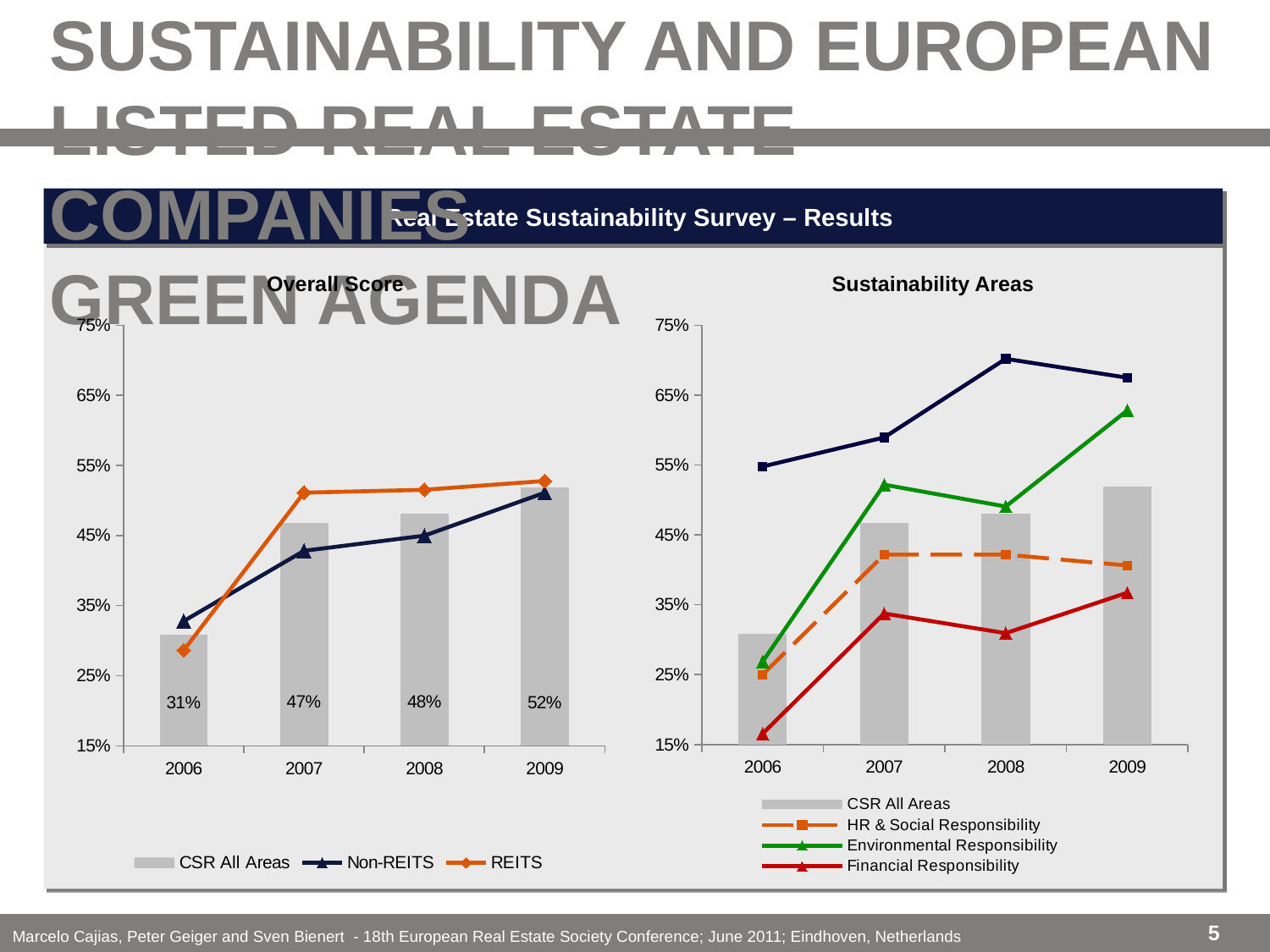
In the Sustainability Areas chart, is the Environmental Responsibility value for 2009 greater or less than 55%? greater In the Sustainability Areas chart, is the HR & Social Responsibility value for 2006 greater or less than 35%? less In the Overall Score chart, how many years are shown on the x axis? 4 In the Overall Score chart, how many series does the legend list? 3 In the Overall Score chart, by how many percentage points did the CSR All Areas value increase from 2006 to 2009? 21 percentage points In the Sustainability Areas chart, how many series does the legend list? 4 In the Overall Score chart, what is the CSR All Areas value for 2006? 31% In the Overall Score chart, which year has the lowest CSR All Areas value? 2006 In the Overall Score chart, is the REITS value for 2007 greater or less than 45%? greater In the Sustainability Areas chart, which is larger in 2006: Environmental Responsibility or Financial Responsibility? Environmental Responsibility In the Overall Score chart, which year has the highest CSR All Areas value? 2009 In the Overall Score chart, what is the CSR All Areas value for 2009? 52%